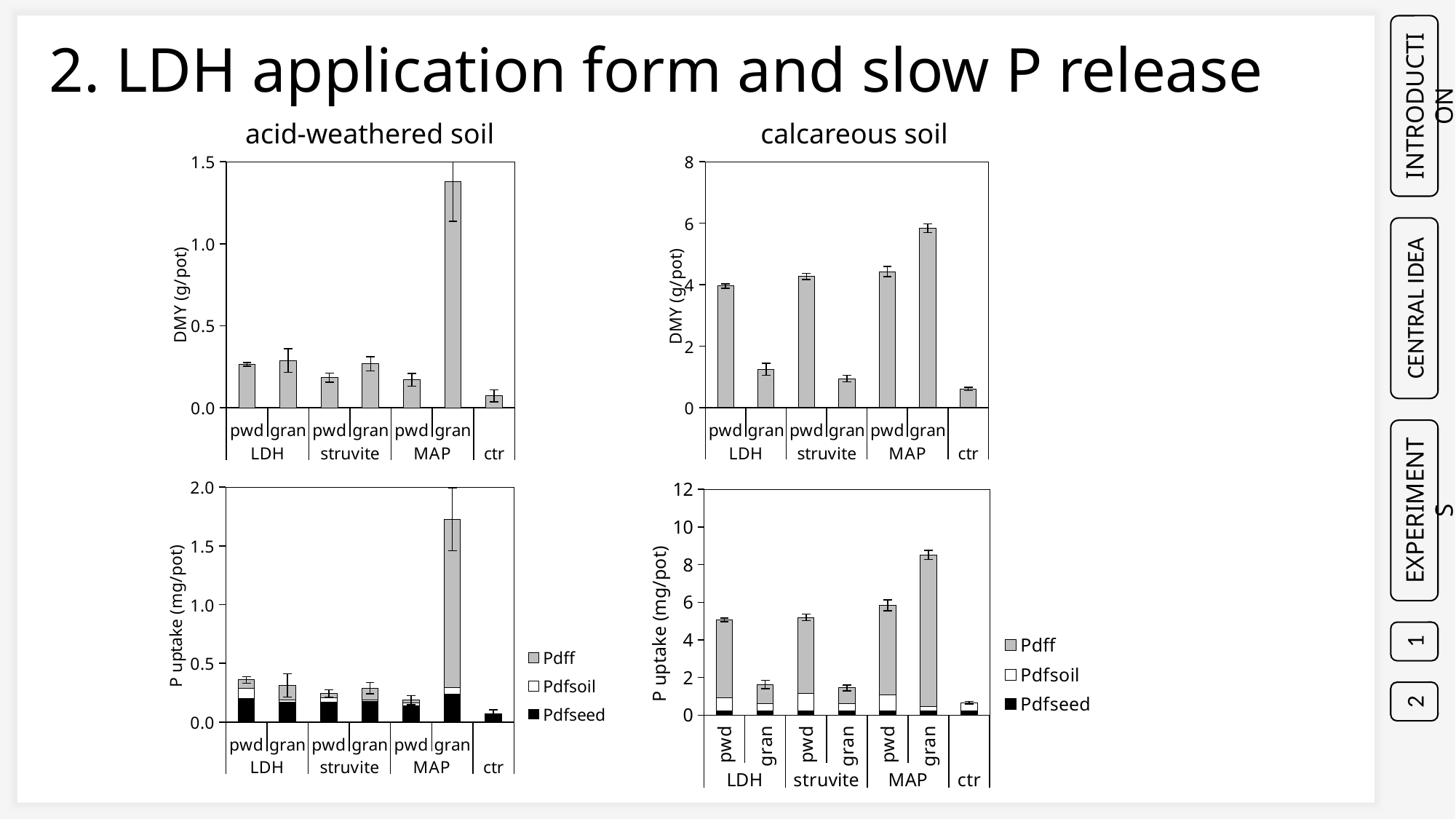
In the top-right chart (DMY, calcareous soil), which is larger, LDH pwd or LDH gran? LDH pwd In the top-left chart (DMY, acid-weathered soil), how many bars are plotted? 7 What kind of chart is the bottom-right chart (P uptake, calcareous soil)? stacked bar chart In the bottom-left chart (P uptake, acid-weathered soil), which bar has the highest total? MAP gran In the top-left chart (DMY, acid-weathered soil), is the value for MAP gran greater or less than 1.0? greater In the bottom-right chart (P uptake, calcareous soil), which bar has the lowest total? ctr In the bottom-left chart (P uptake, acid-weathered soil), how many series does the legend list? 3 In the top-left chart (DMY, acid-weathered soil), which bar is the lowest? ctr In the top-left chart (DMY, acid-weathered soil), which bar is the highest? MAP gran In the bottom-right chart (P uptake, calcareous soil), is the total for MAP gran greater or less than 8? greater In the top-right chart (DMY, calcareous soil), is the value for struvite gran greater or less than 2? less In the top-right chart (DMY, calcareous soil), which bar is the highest? MAP gran